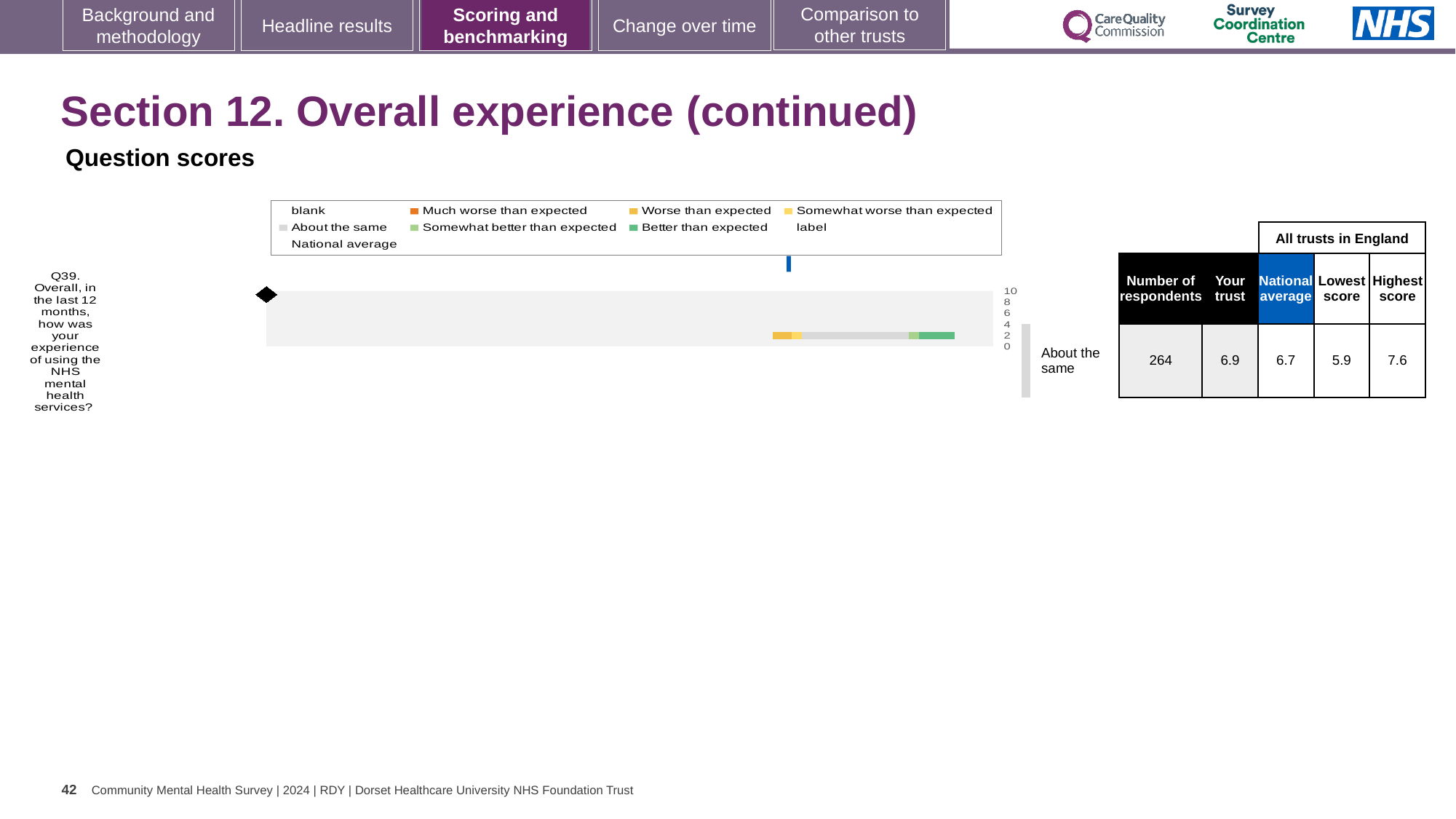
By how much does the trust's score for Q39 exceed the national average? 0.2 How many respondents answered Q39? 264 Which survey question is plotted on the chart? Q39. Overall, in the last 12 months, how was your experience of using the NHS mental health services? What is the difference between the highest and lowest trust scores for Q39? 1.7 What is the national average score for Q39? 6.7 Which benchmarking category does the trust's Q39 score fall into? About the same How many questions are plotted on the chart? 1 What is the highest score among all trusts in England for Q39? 7.6 What is the lowest score among all trusts in England for Q39? 5.9 Which is higher for Q39, the trust's score or the national average? Your trust (6.9) How many entries does the chart legend list? 9 What is the 'Your trust' score for Q39? 6.9